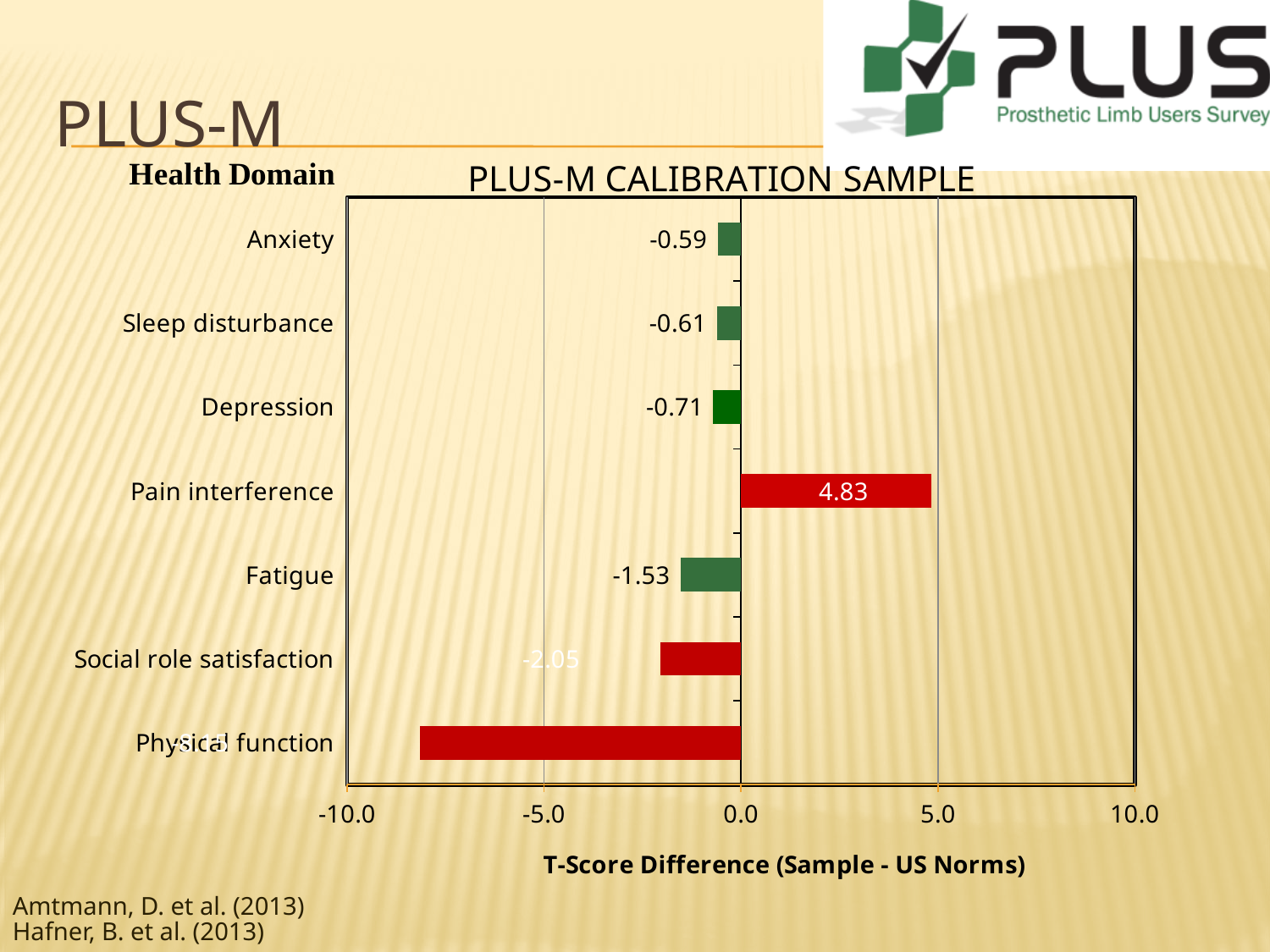
What is the T-score difference for Depression? -0.71 Which health domain has the highest T-score difference? Pain interference What is the T-score difference for Anxiety? -0.59 What is the T-score difference for Fatigue? -1.53 How many health domains are shown in the chart? 7 What type of chart is shown on the slide? Bar chart What is the T-score difference for Pain interference? 4.83 Which health domain has the lowest T-score difference? Physical function What is the T-score difference for Social role satisfaction? -2.05 Which is larger, the T-score difference for Fatigue or for Social role satisfaction? Fatigue What is the difference between the T-score difference for Pain interference and that for Fatigue? 6.36 Is the T-score difference for Physical function greater or less than -5.0? less